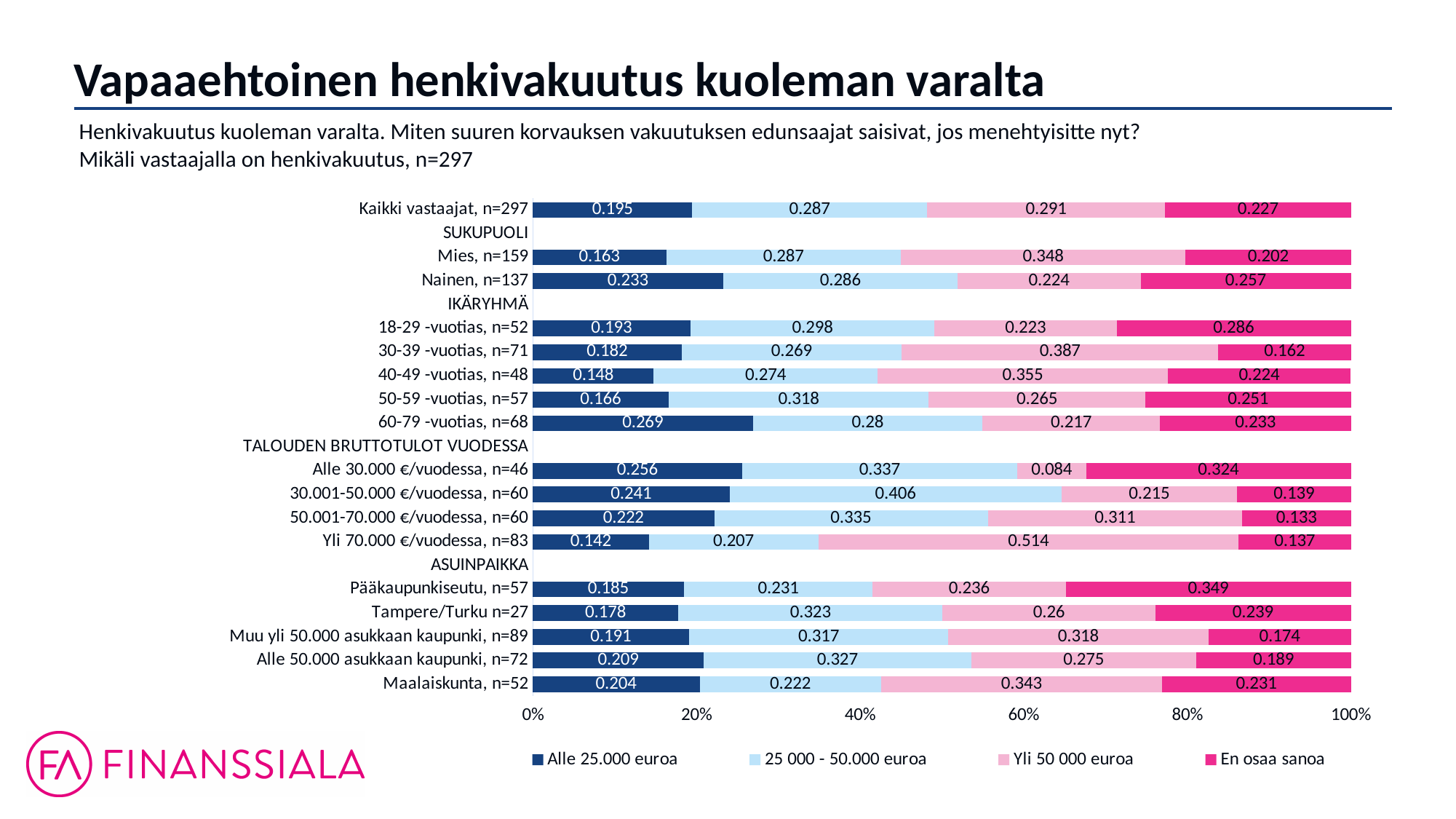
How many series does the legend list? 4 What is the title of the slide? Vapaaehtoinen henkivakuutus kuoleman varalta Which has the larger 'En osaa sanoa' value: 'Pääkaupunkiseutu, n=57' or 'Maalaiskunta, n=52'? Pääkaupunkiseutu, n=57 What is the value of 'En osaa sanoa' for 'Pääkaupunkiseutu, n=57'? 0.349 What kind of chart is shown on the slide? Stacked bar chart Which category has the highest value for 'Alle 25.000 euroa'? 60-79 -vuotias, n=68 What is the difference between the 'Alle 25.000 euroa' values for 'Nainen, n=137' and 'Mies, n=159'? 0.07 What is the value of '25 000 - 50.000 euroa' for '30.001-50.000 €/vuodessa, n=60'? 0.406 Which category has the lowest value for 'Yli 50 000 euroa'? Alle 30.000 €/vuodessa, n=46 Which category has the highest value for 'Yli 50 000 euroa'? Yli 70.000 €/vuodessa, n=83 What is the value of 'Alle 25.000 euroa' for '60-79 -vuotias, n=68'? 0.269 What is the value of 'Yli 50 000 euroa' for 'Yli 70.000 €/vuodessa, n=83'? 0.514